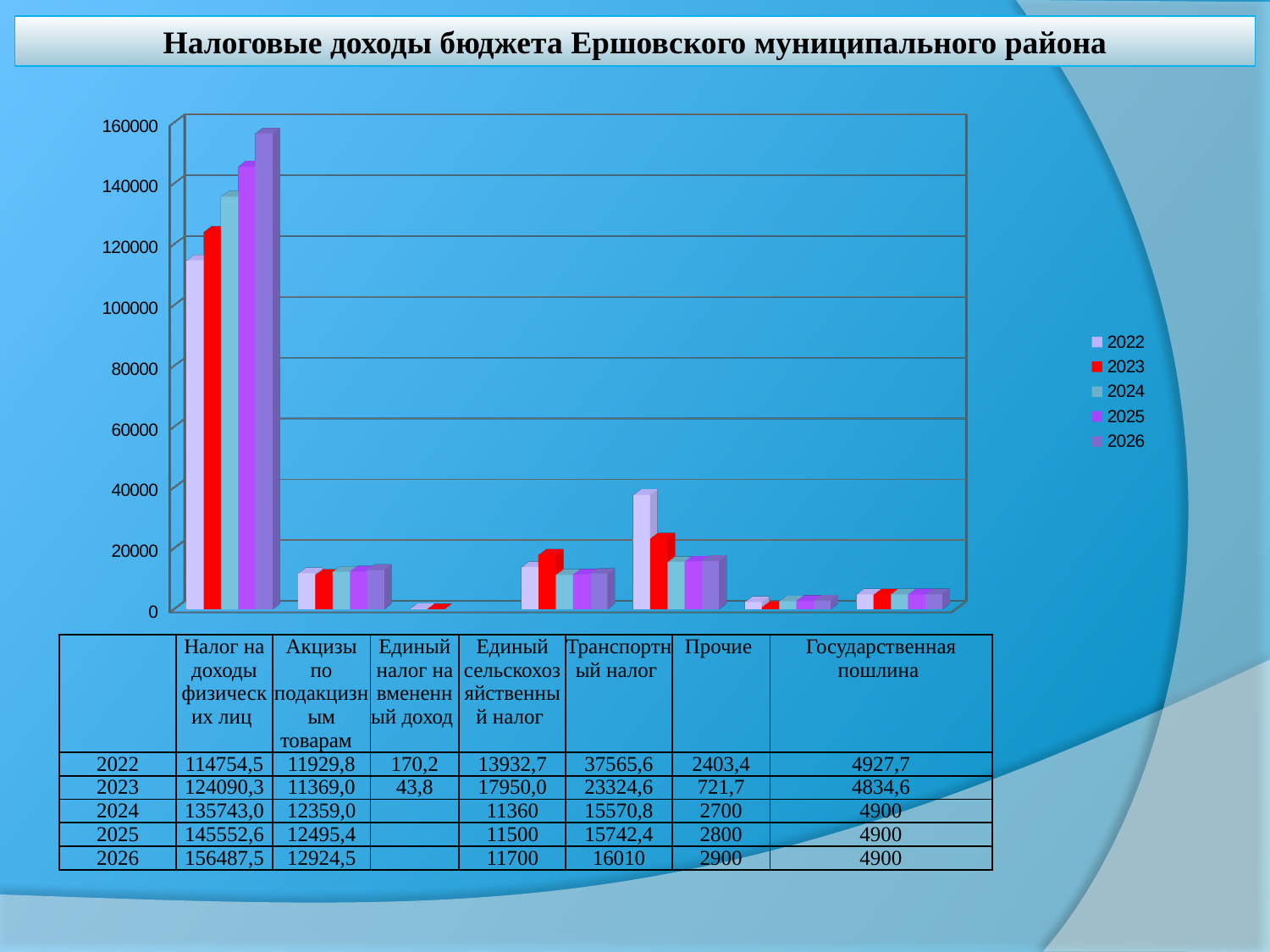
How many series does the legend list? 5 What is the value for Налог на доходы физических лиц in 2022? 114754,5 How many categories are shown on the x axis of the chart? 7 Do the values for Налог на доходы физических лиц rise or fall from 2022 to 2026? rise Is the value for Транспортный налог in 2022 greater or less than 20000? greater Which category has the highest value in 2026? Налог на доходы физических лиц Which category has the lowest value in 2022? Единый налог на вмененный доход What is the difference between the 2026 and 2022 values for Налог на доходы физических лиц? 41733 Which is larger for Транспортный налог: the 2022 value or the 2023 value? 2022 What is the value for Транспортный налог in 2023? 23324,6 What kind of chart is shown on the slide? bar chart What is the value for Государственная пошлина in 2026? 4900